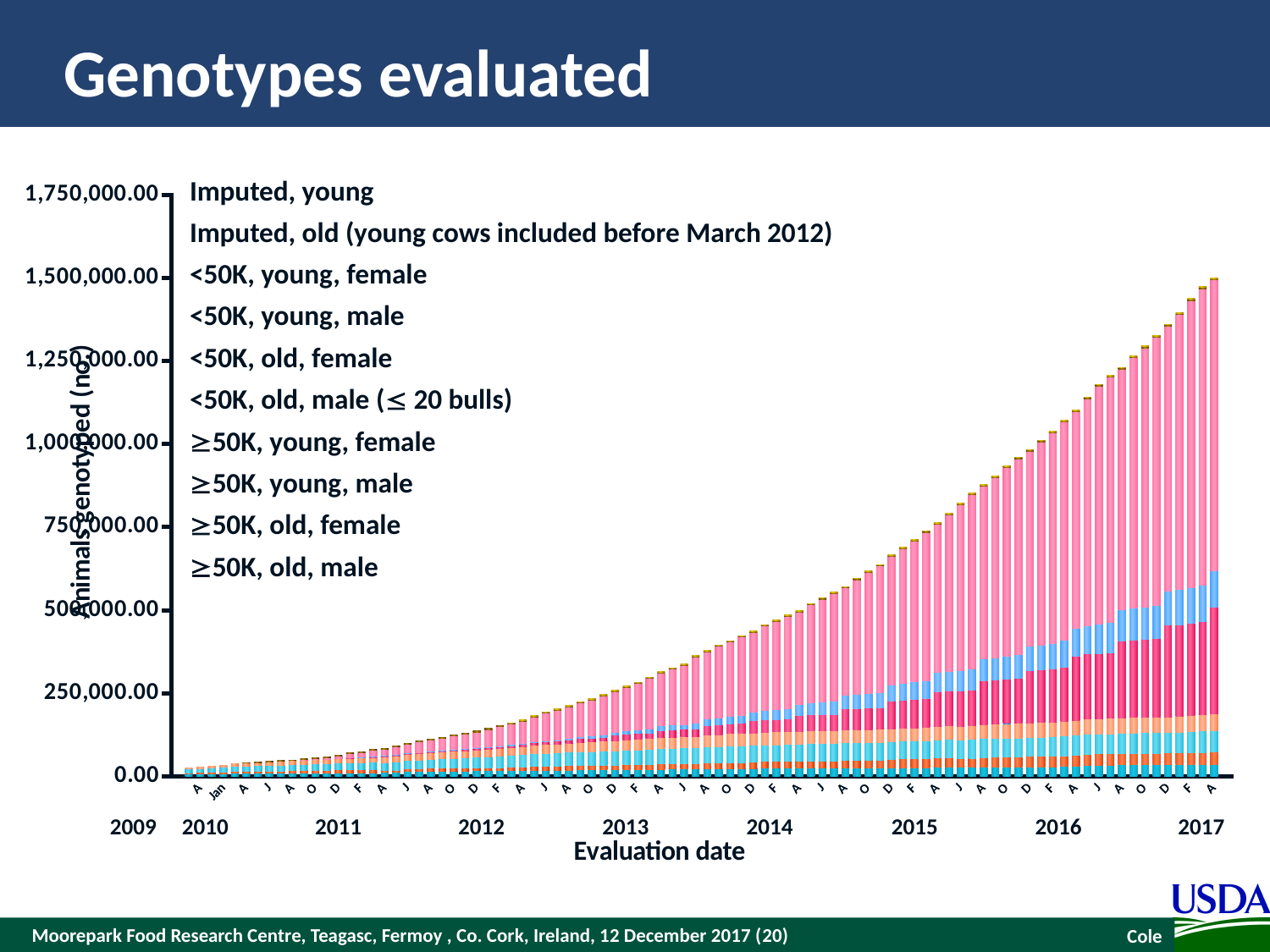
What is the first entry in the legend? Imputed, young What is the title of the x axis? Evaluation date Is the tallest bar (the last bar in 2017) greater or less than 1,250,000.00? greater Do the bar heights rise or fall from 2009 to 2017? rise What kind of chart is shown on the slide? stacked bar chart Which is taller, the last bar in 2013 or the last bar in 2016? the last bar in 2016 Which year contains the tallest bar? 2017 Are the bars in 2010 greater or less than 250,000.00? less How many series does the legend list? 10 Is the last bar in 2015 greater or less than 750,000.00? greater